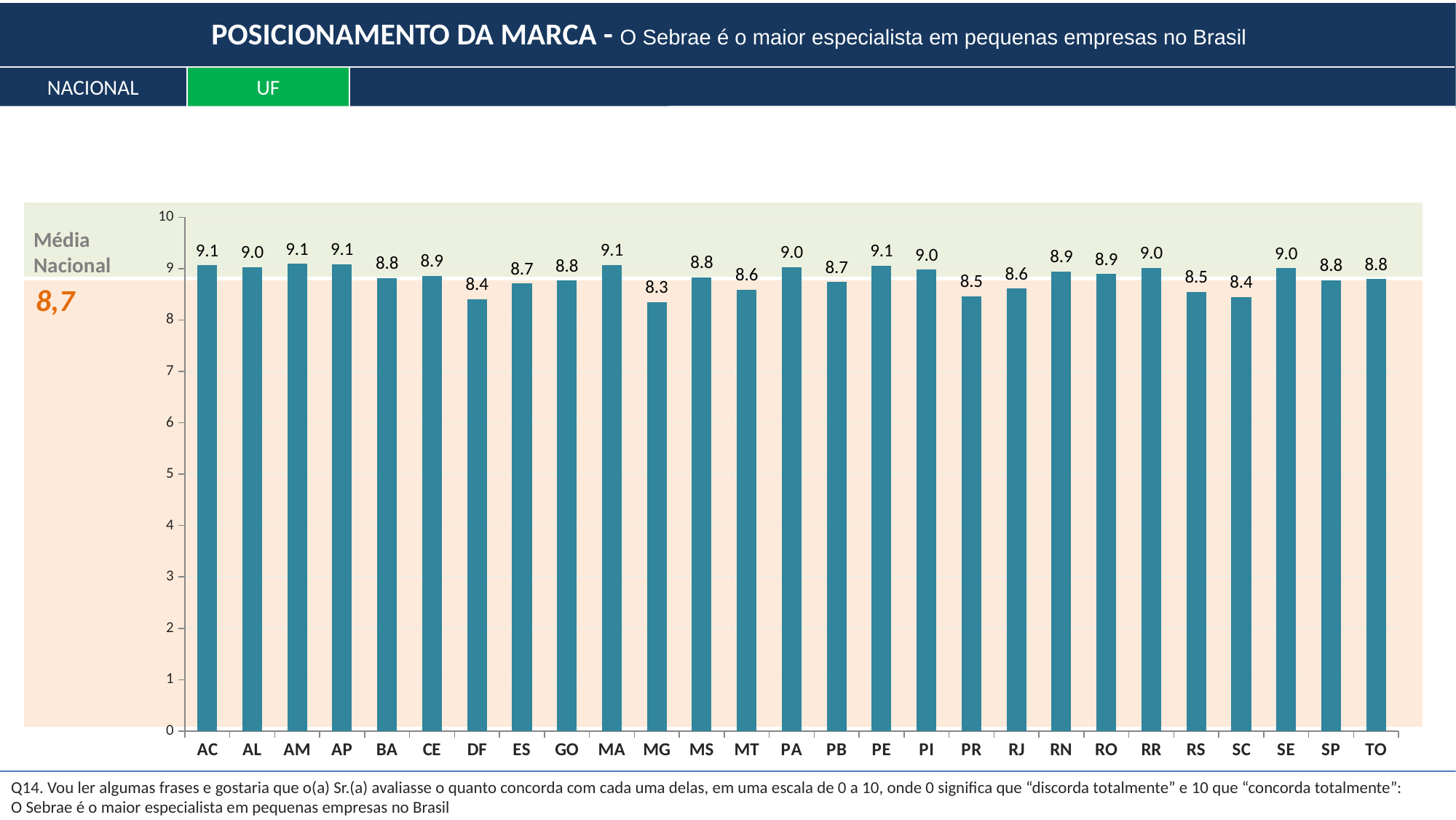
What is the value for RJ? 8.6 What is the value for SP? 8.8 What is the value for DF? 8.4 Which state has the lowest value? MG What is the difference between the values for PA and PR? 0.5 What is the difference between the values for AC and MG? 0.8 How many states are shown on the x axis? 27 Which is larger, the value for CE or the value for SC? CE What kind of chart is shown on the slide? bar chart What is the value of the Média Nacional shown on the chart? 8,7 Is the value for MT greater or less than 8? greater What is the value for PE? 9.1